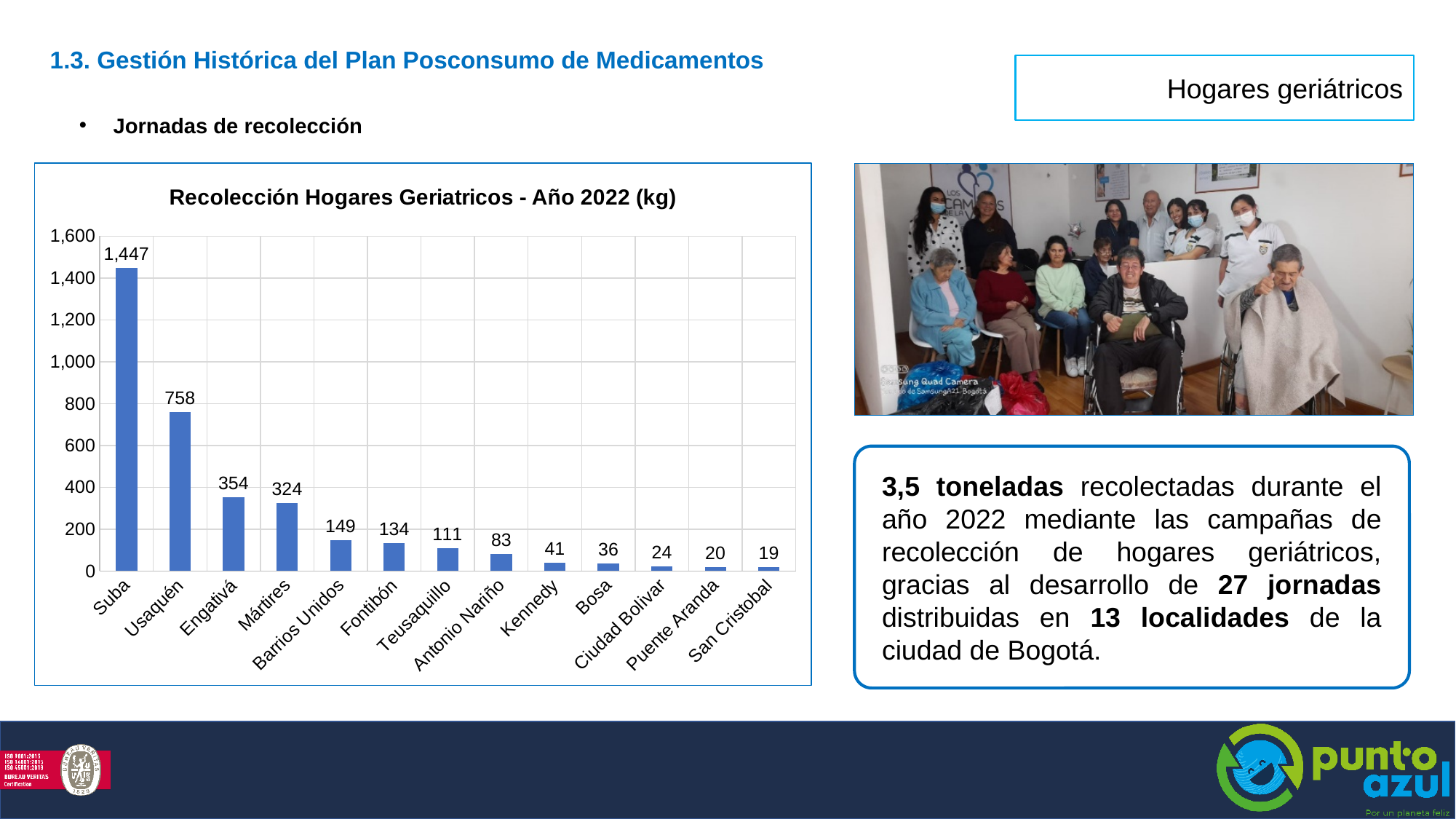
How many categories are shown in the chart? 13 What is the value for Suba in the chart? 1,447 Which category has the highest value in the chart? Suba What is the value for Barrios Unidos in the chart? 149 What is the title of the chart? Recolección Hogares Geriatricos - Año 2022 (kg) What is the difference between the values for Suba and Usaquén? 689 Which is larger, the value for Fontibón or the value for Teusaquillo? Fontibón What is the difference between the values for Engativá and Mártires? 30 What kind of chart is shown on the slide? Bar chart What is the value for Kennedy in the chart? 41 Which category has the lowest value in the chart? San Cristobal Do the values rise or fall from left to right along the x axis? Fall